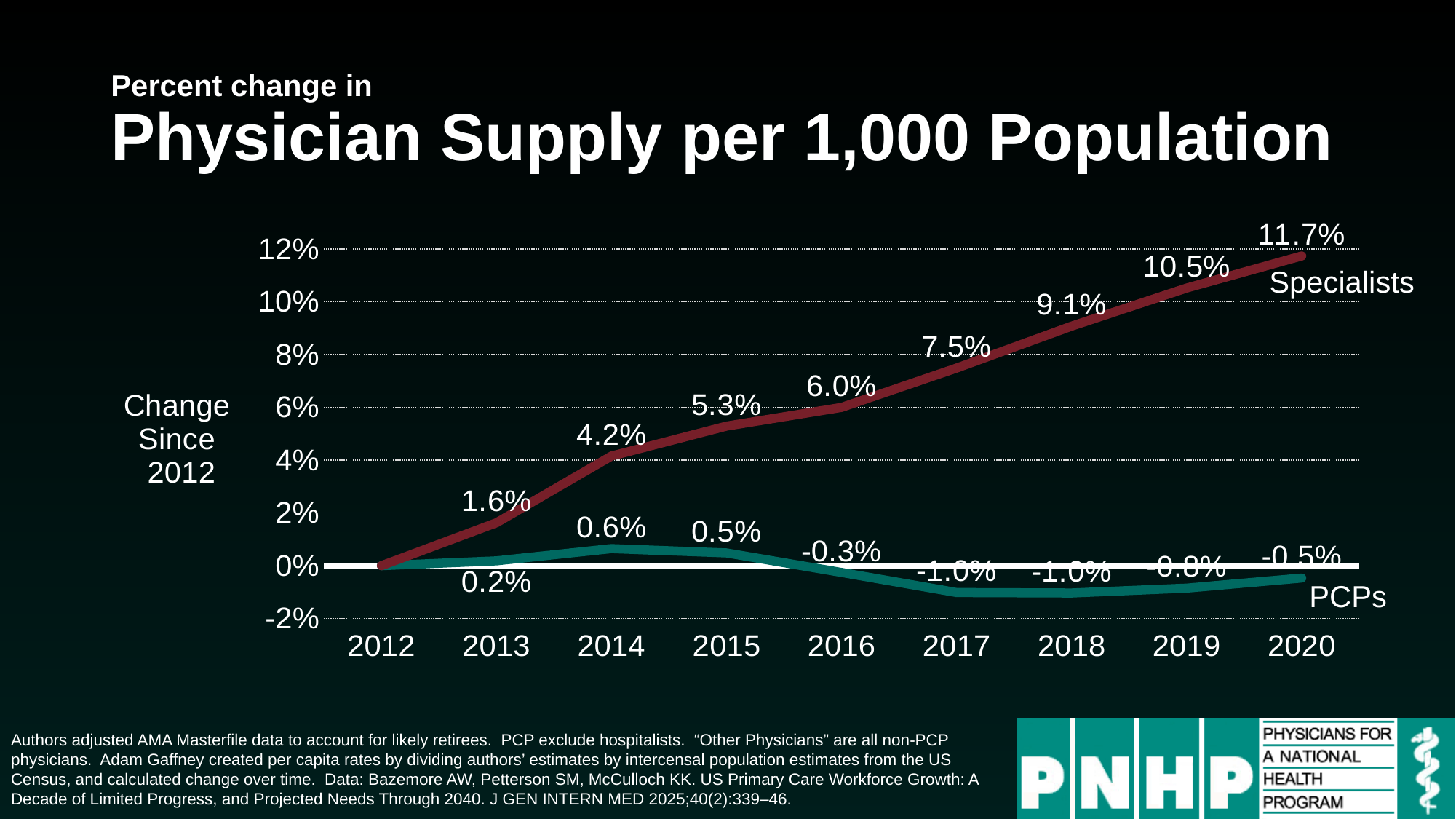
Does the Specialists line rise or fall from 2012 to 2020? Rises Which series has the larger value in 2016, Specialists or PCPs? Specialists What is the difference between the Specialists and PCPs values in 2020? 12.2% In which year does the Specialists line reach its highest value? 2020 What is the value for Specialists in 2015? 5.3% What is the value for Specialists in 2020? 11.7% What kind of chart is shown on the slide? Line chart How many years are shown on the x axis? 9 What is the value for PCPs in 2017? -1.0% What is the label on the y axis of the chart? Change Since 2012 What is the value for PCPs in 2014? 0.6% How many series are plotted on the chart? 2